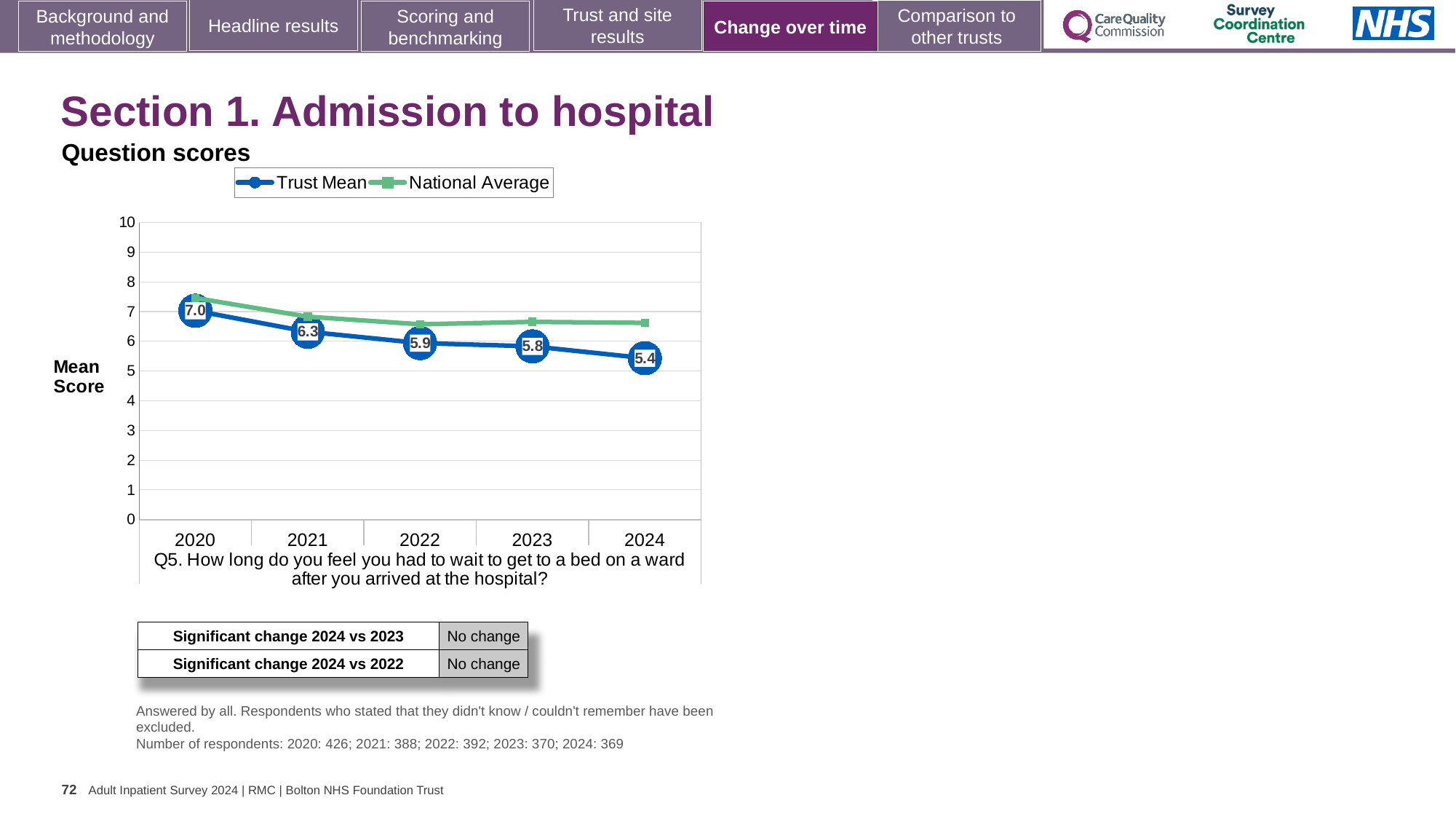
Does the Trust Mean score rise or fall from 2020 to 2024? Fall What is the Trust Mean score for 2022? 5.9 Is the National Average value for 2020 greater or less than 7? greater In which year is the Trust Mean score lowest? 2024 How many series does the legend list? 2 How many years are plotted on the x axis? 5 What is the Trust Mean score for 2020? 7.0 What is the difference between the Trust Mean score in 2020 and in 2024? 1.6 What is the Trust Mean score for 2024? 5.4 In which year is the Trust Mean score highest? 2020 Which is larger, the Trust Mean score in 2021 or in 2023? 2021 What kind of chart is shown on the slide? Line chart